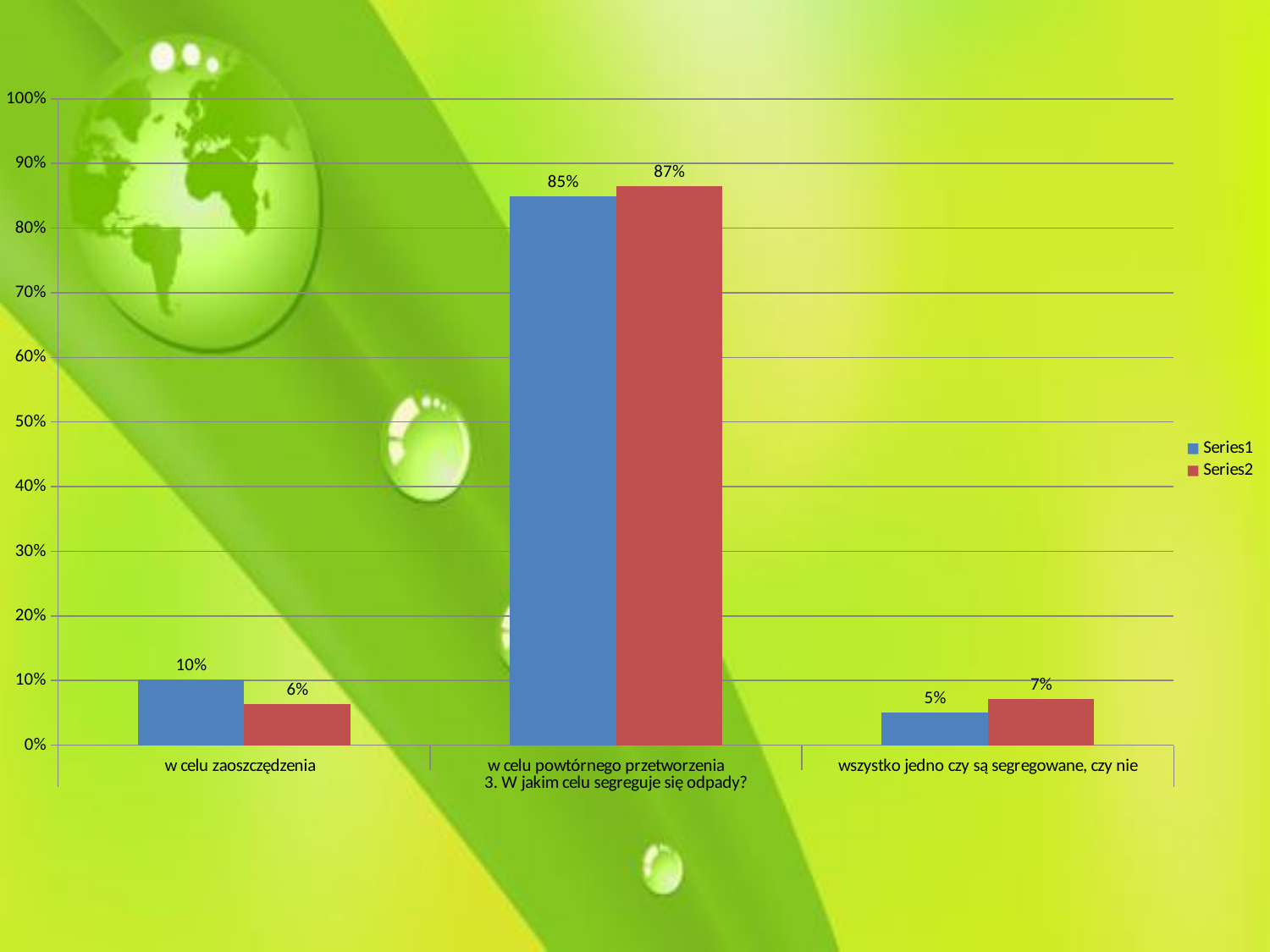
What is the x-axis title of the chart? 3. W jakim celu segreguje się odpady? What is the Series1 value for "w celu powtórnego przetworzenia"? 85% How many series does the legend list? 2 Which category has the lowest Series2 value? w celu zaoszczędzenia What kind of chart is shown on the slide? bar chart What is the Series2 value for "wszystko jedno czy są segregowane, czy nie"? 7% What is the Series2 value for "w celu zaoszczędzenia"? 6% How many categories are shown on the x axis? 3 What is the difference between the Series2 and Series1 values for "w celu powtórnego przetworzenia"? 2% Which category has the highest Series1 value? w celu powtórnego przetworzenia Which is larger for "w celu zaoszczędzenia": Series1 or Series2? Series1 Is the Series1 value for "w celu powtórnego przetworzenia" greater or less than 80%? greater